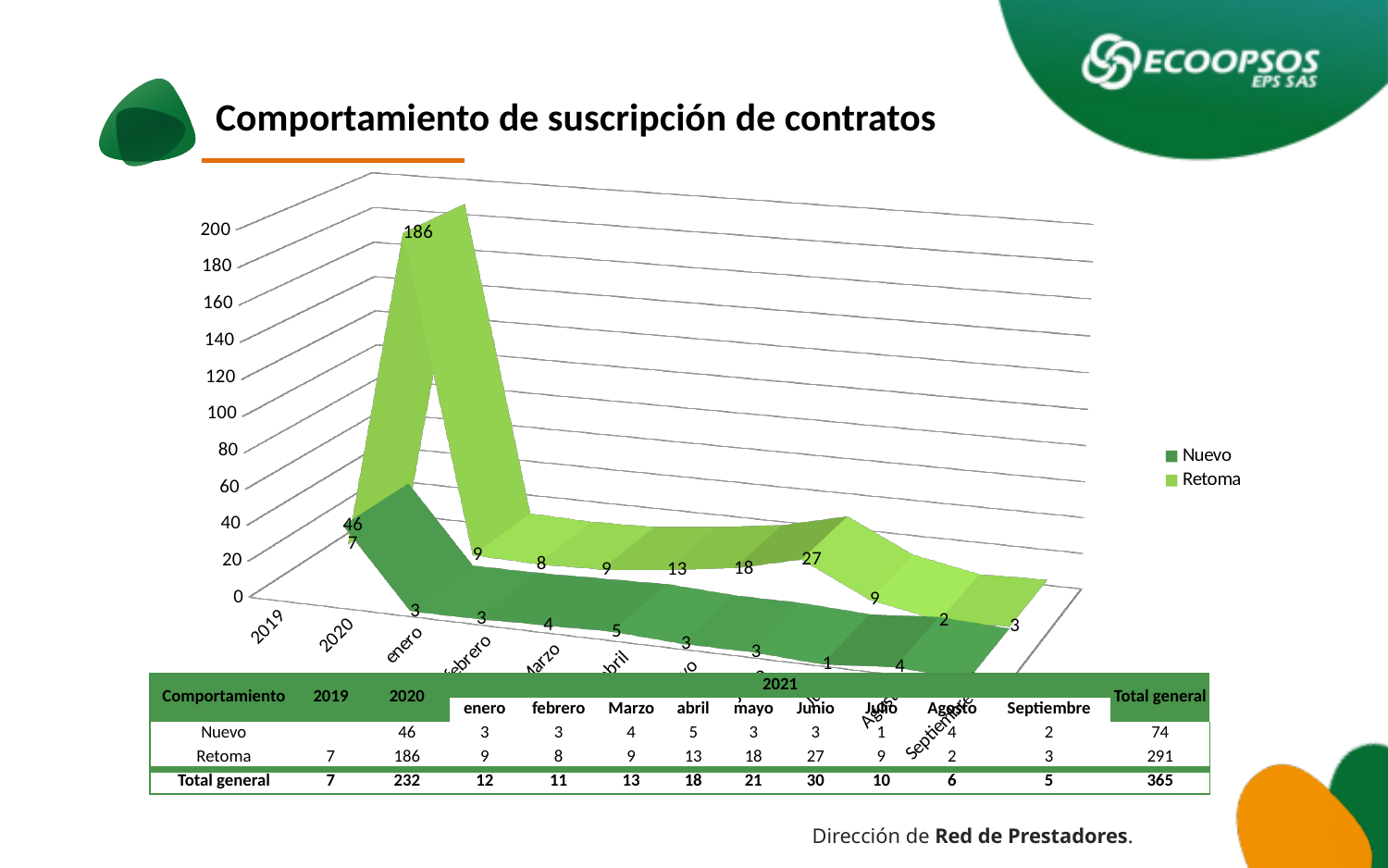
What is the value for Nuevo in abril 2021? 5 How many series does the legend list? 2 What is the title of the chart? Comportamiento de suscripción de contratos Which period has the highest value for Retoma? 2020 Which period has the lowest value for Nuevo? Julio 2021 What is the value for Retoma in 2020? 186 Which is larger in mayo 2021, Nuevo or Retoma? Retoma What kind of chart is shown? 3D line chart Is the value for Retoma in 2020 greater or less than 180? greater What is the value for Retoma in Junio 2021? 27 What is the value for Nuevo in 2020? 46 What is the difference between Retoma and Nuevo in 2020? 140